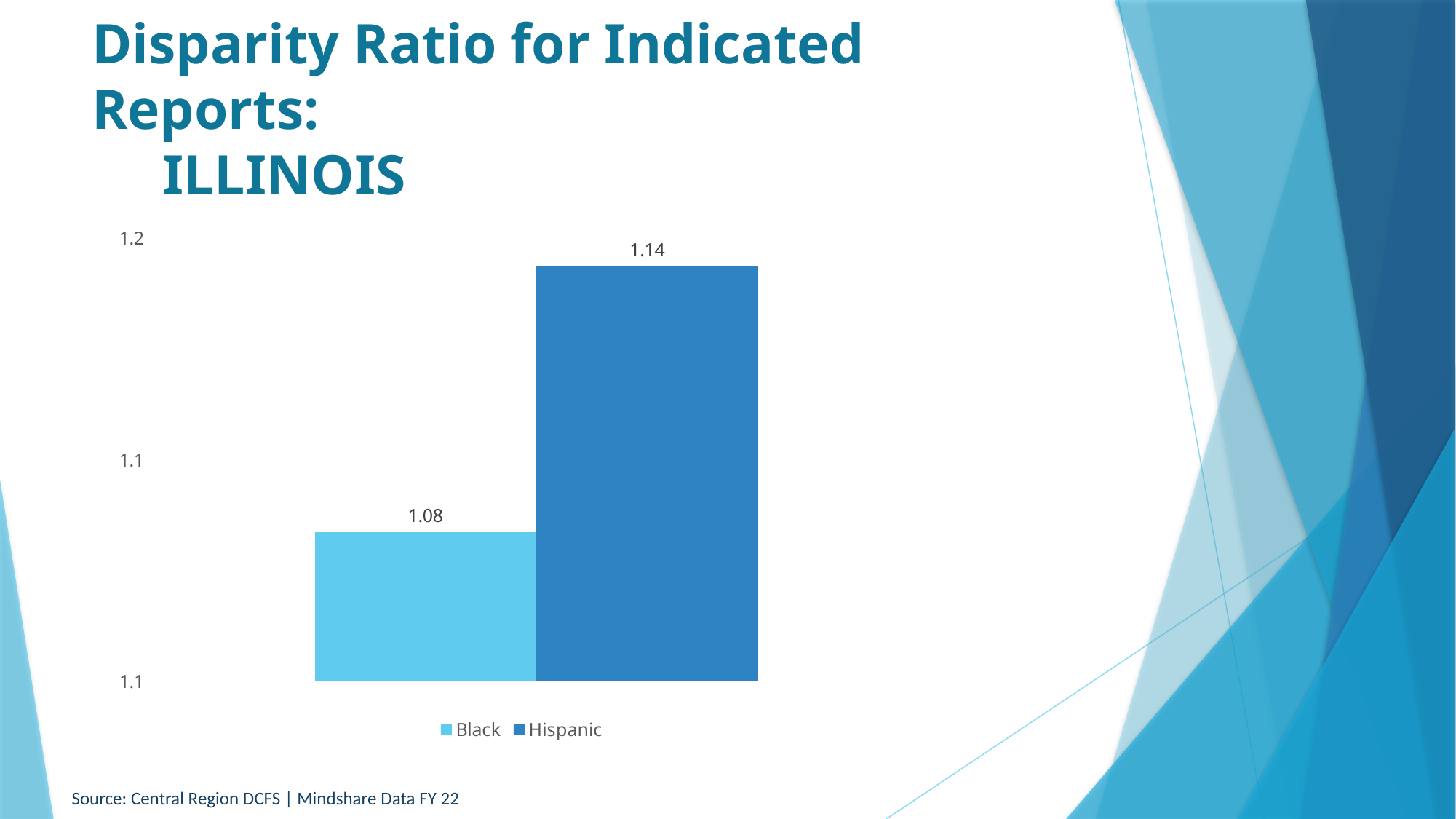
What is the difference between the Hispanic and Black disparity ratios? 0.06 How many bars are plotted in the chart? 2 Is the value for Black greater or less than 1.1? less Which group has the lower disparity ratio? Black Is the disparity ratio for Black larger or smaller than the ratio for Hispanic? smaller What is the disparity ratio for Black? 1.08 How many entries does the legend list? 2 What is the disparity ratio for Hispanic? 1.14 Is the value for Hispanic greater or less than 1.1? greater What is the title of the slide? Disparity Ratio for Indicated Reports: ILLINOIS Which group has the higher disparity ratio? Hispanic What kind of chart is shown on the slide? bar chart